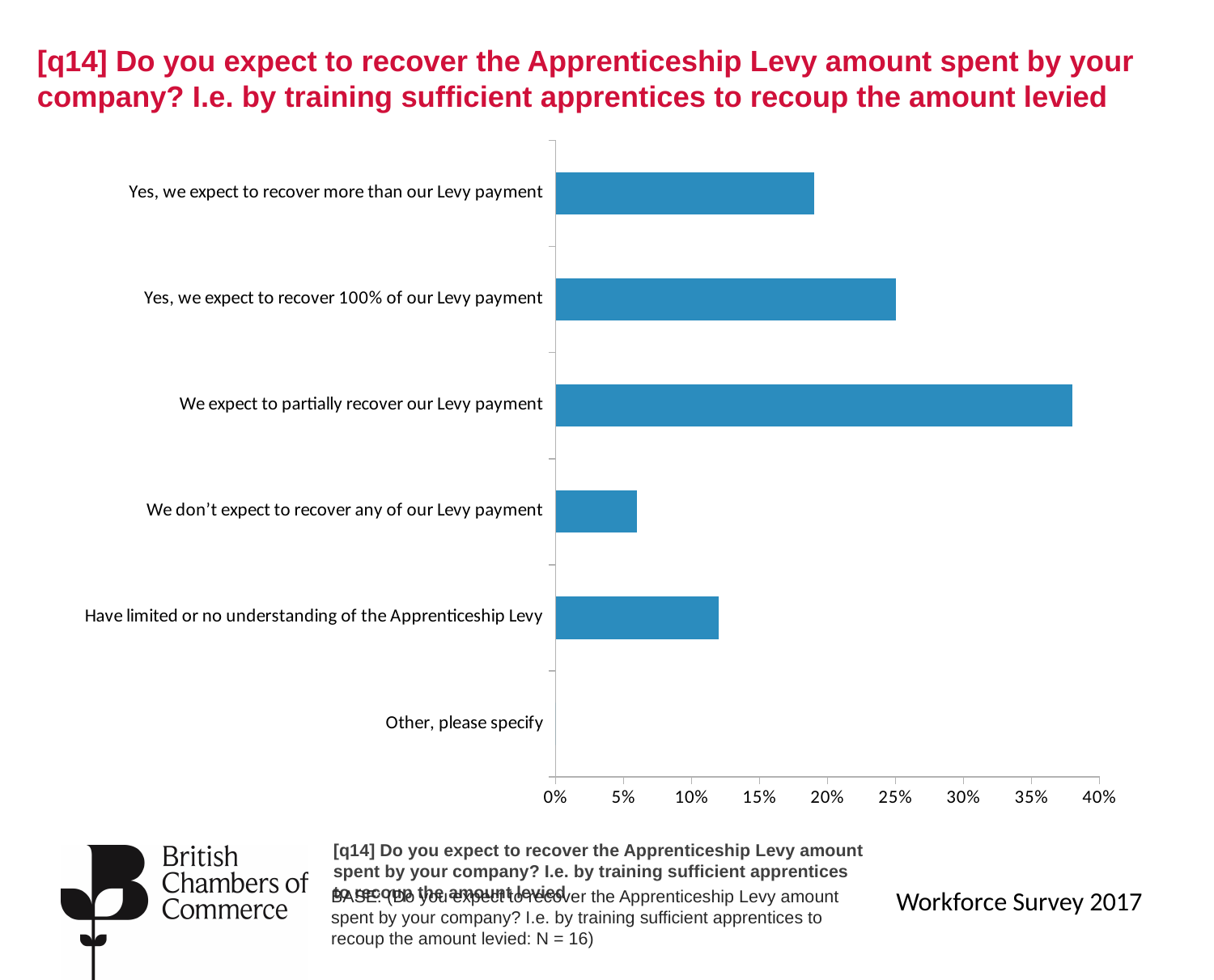
Is the value for "Yes, we expect to recover more than our Levy payment" greater or less than 20%? less How many response categories are shown on the chart? 6 Which is larger: the value for "Yes, we expect to recover 100% of our Levy payment" or the value for "Yes, we expect to recover more than our Levy payment"? Yes, we expect to recover 100% of our Levy payment Is the value for "We expect to partially recover our Levy payment" greater or less than 35%? greater Is the value for "We don't expect to recover any of our Levy payment" greater or less than 10%? less Which response category has the highest value? We expect to partially recover our Levy payment Which is larger: the value for "Have limited or no understanding of the Apprenticeship Levy" or the value for "We don't expect to recover any of our Levy payment"? Have limited or no understanding of the Apprenticeship Levy Which response category has the lowest value? Other, please specify What is the sample size (N) stated in the base note below the chart? 16 What kind of chart is shown on the slide? bar chart What is the maximum value shown on the horizontal axis of the chart? 40%